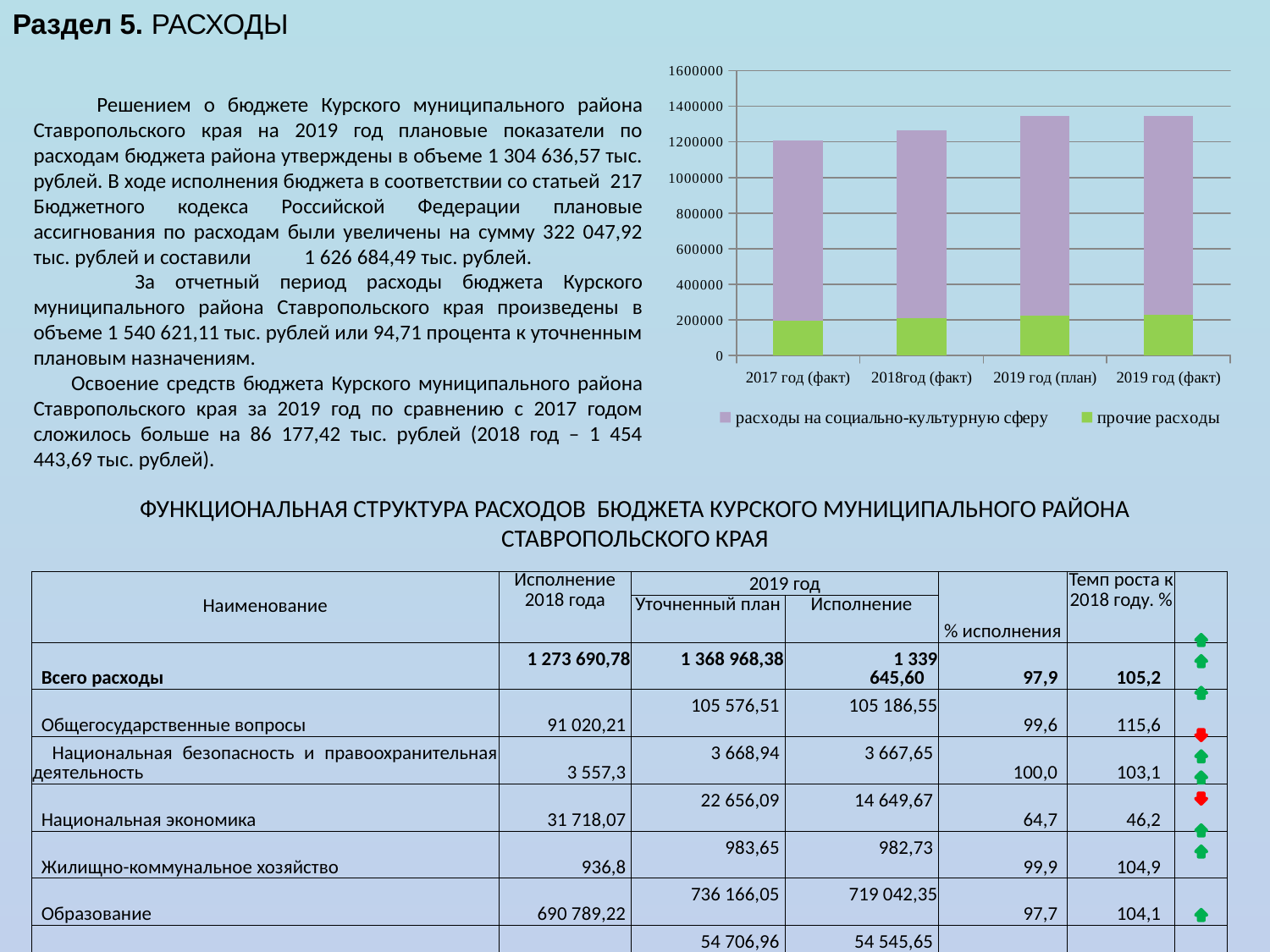
Which has the larger total bar: 2017 год (факт) or 2019 год (план)? 2019 год (план) How many categories are shown on the x axis of the chart? 4 Which category has the lowest total bar height in the chart? 2017 год (факт) What is the first series listed in the chart legend? расходы на социально-культурную сферу Is the total bar for 2019 год (план) greater or less than 1400000? less How many series does the chart legend list? 2 Is the total bar for 2017 год (факт) greater or less than 1000000? greater Is the value of прочие расходы for 2019 год (факт) greater or less than 200000? greater What kind of chart is shown on the slide? stacked bar chart Do the total bar heights rise or fall from 2017 год (факт) to 2019 год (план)? rise Which series is shown in green in the chart? прочие расходы